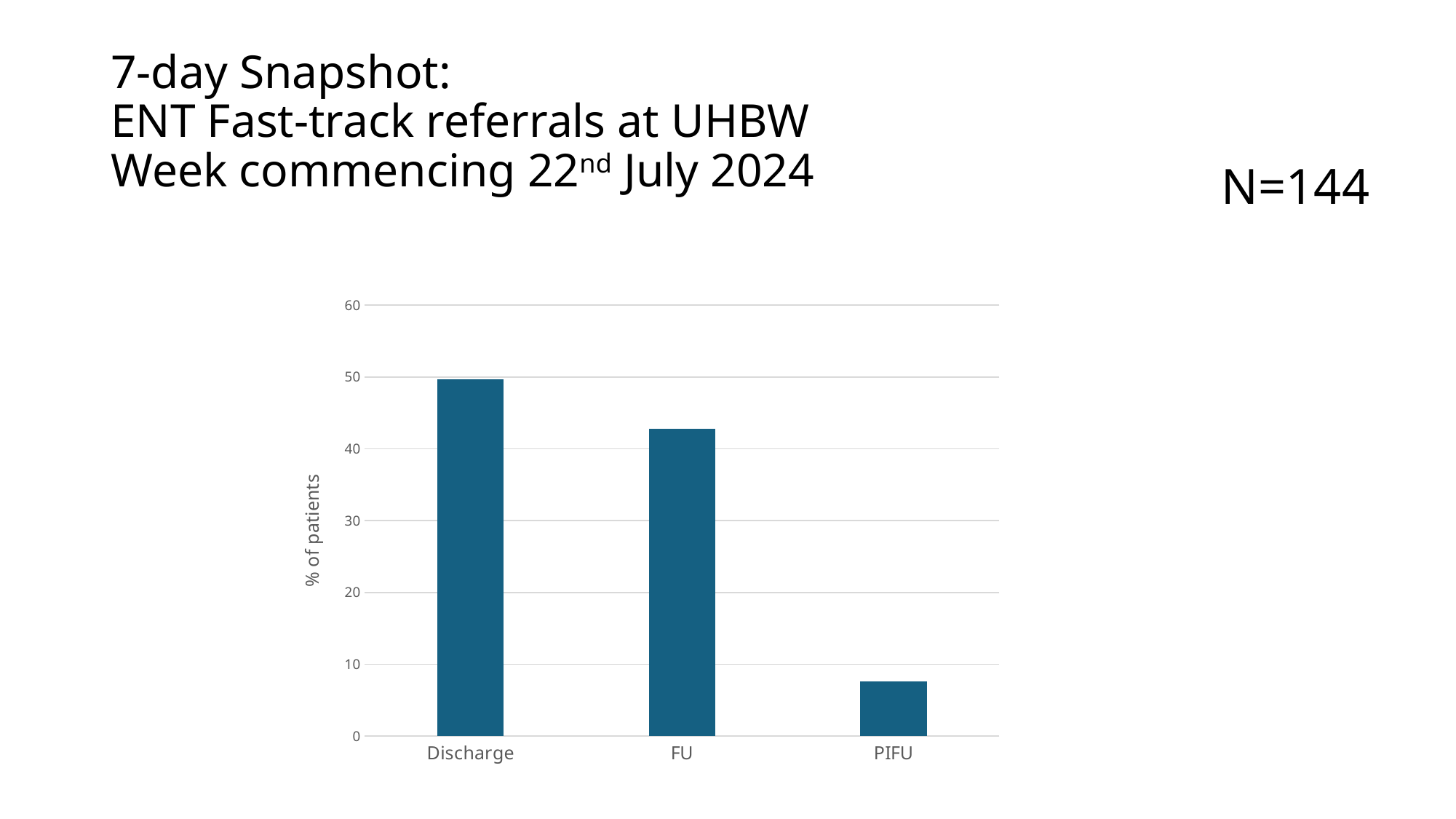
How many categories are plotted on the x axis? 3 Is the value for Discharge greater or less than 40? greater Which category has the highest value? Discharge Which category has the lowest value? PIFU Is the value for PIFU greater or less than 10? less Which is larger, the value for Discharge or the value for FU? Discharge Which is larger, the value for FU or the value for PIFU? FU What kind of chart is shown on the slide? bar chart Is the value for FU greater or less than 50? less Do the values rise or fall from left to right along the x axis? fall What is the label of the y axis? % of patients